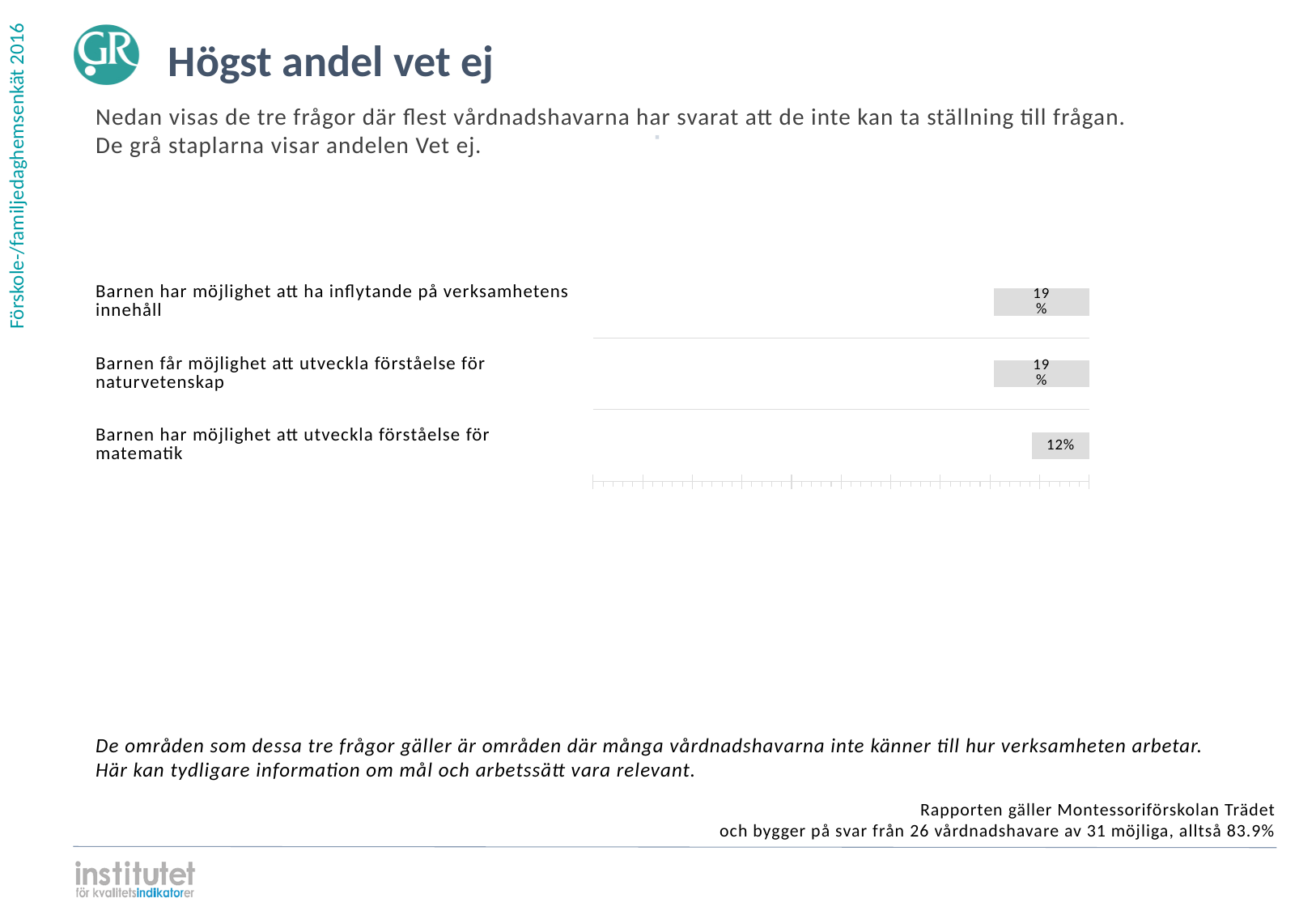
What is the value shown for "Barnen får möjlighet att utveckla förståelse för naturvetenskap"? 19% What is the value shown for "Barnen har möjlighet att utveckla förståelse för matematik"? 12% Which is larger: the value for "naturvetenskap" or the value for "matematik"? naturvetenskap What is the difference between the value for "inflytande på verksamhetens innehåll" and the value for "matematik"? 7 percentage points How many categories are shown in the chart? 3 Which category has the lowest value in the chart? Barnen har möjlighet att utveckla förståelse för matematik What kind of chart is shown on the slide? bar chart Which is larger: the value for "inflytande på verksamhetens innehåll" or the value for "matematik"? inflytande på verksamhetens innehåll What colour are the bars in the chart? grey What is the difference between the value for "naturvetenskap" and the value for "matematik"? 7 percentage points What is the value shown for "Barnen har möjlighet att ha inflytande på verksamhetens innehåll"? 19% What is the title of the slide containing the chart? Högst andel vet ej